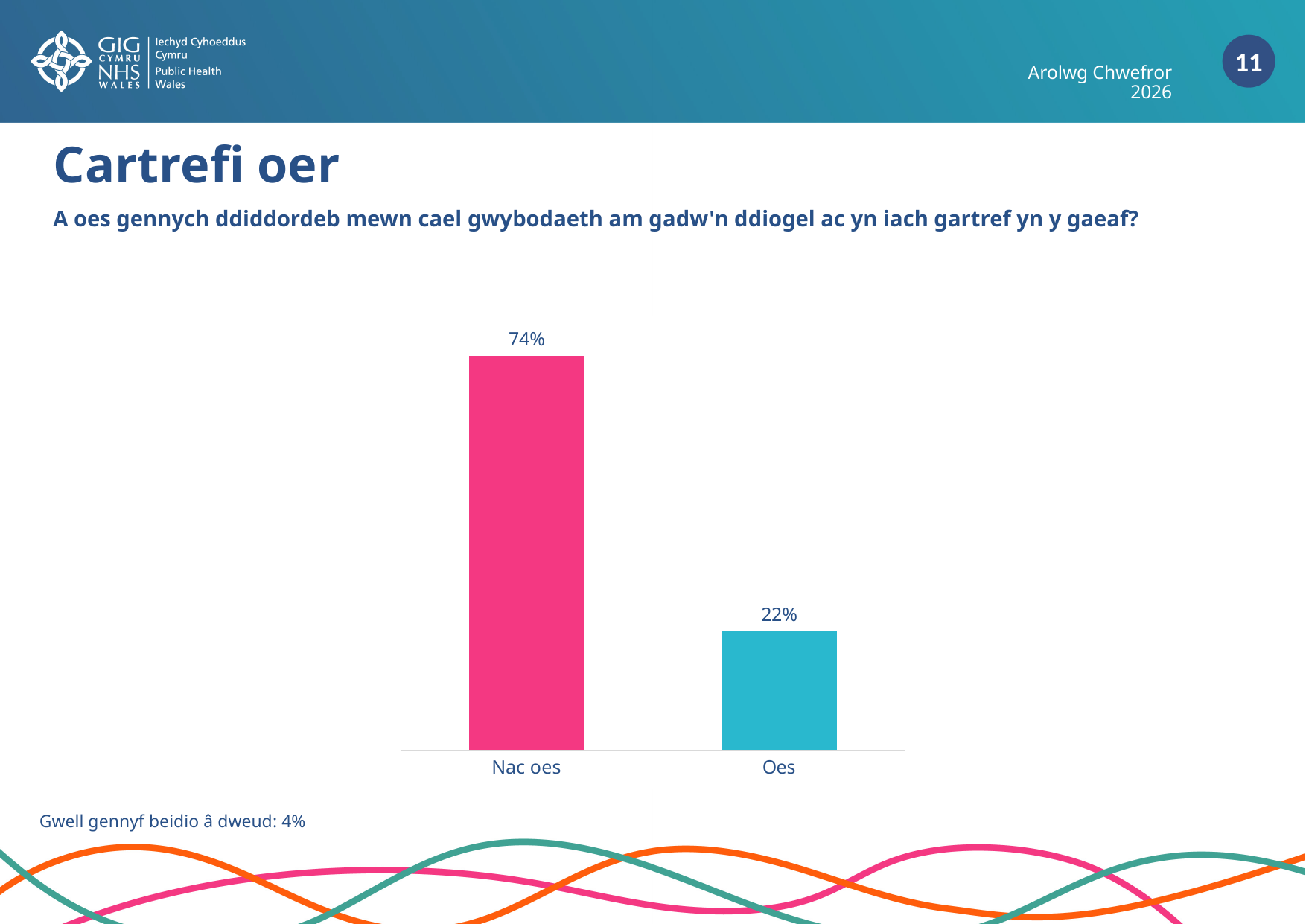
What is the total of the two plotted values? 96% Which category has the highest value? Nac oes What colour is the bar for Nac oes? Pink What is the difference between the values for Nac oes and Oes? 52% What is the value for Nac oes? 74% What percentage is given for 'Gwell gennyf beidio â dweud' below the chart? 4% Which category has the lowest value? Oes What is the value for Oes? 22% What kind of chart is shown on the slide? Bar chart Which is larger, the value for Nac oes or the value for Oes? Nac oes How many categories are shown in the chart? 2